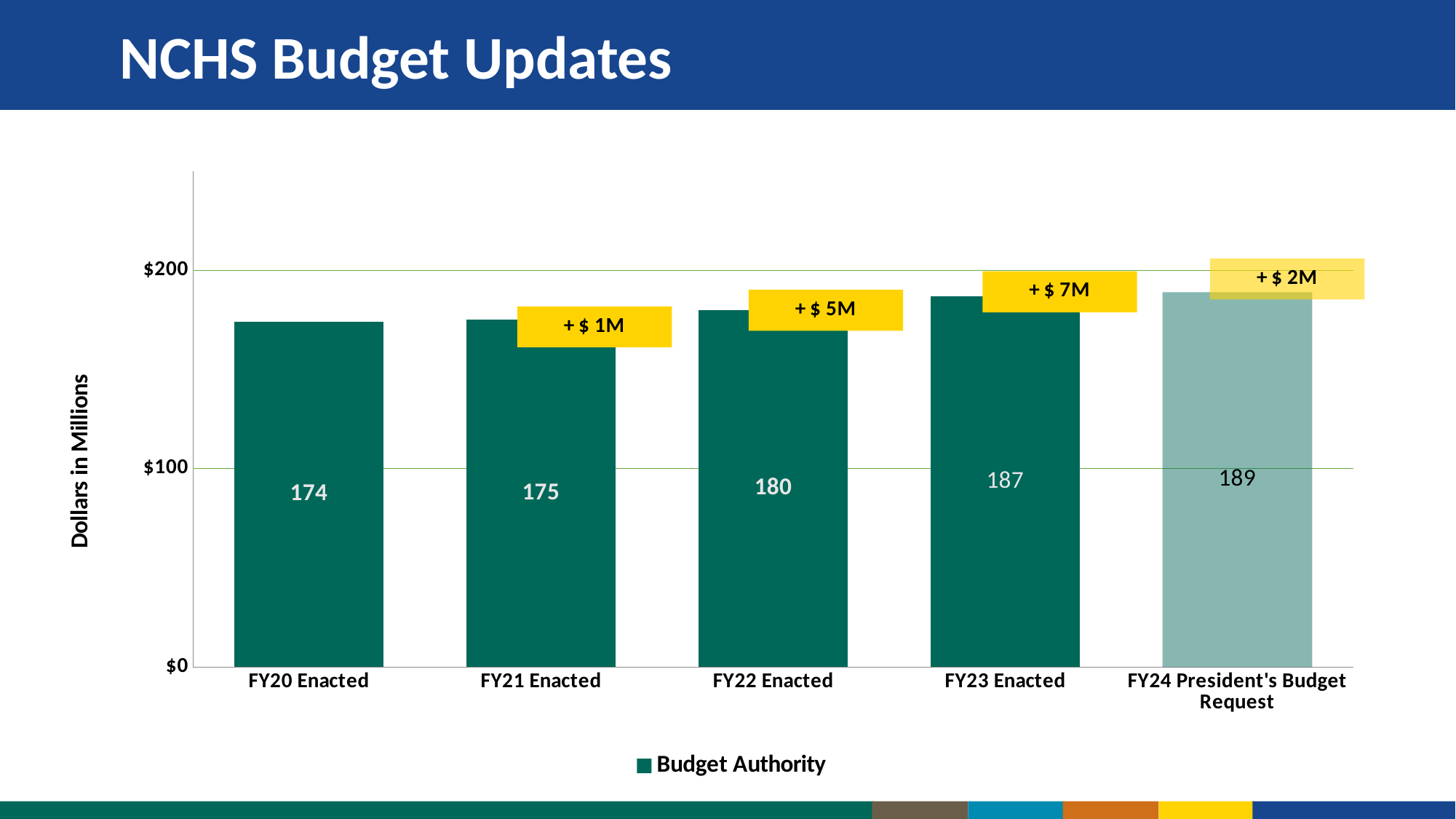
What is the Budget Authority value for FY24 President's Budget Request? 189 What kind of chart is shown on the slide? bar chart What is the Budget Authority value for FY22 Enacted? 180 What is the difference between the FY23 Enacted and FY22 Enacted values? 7 What is the Budget Authority value for FY20 Enacted? 174 Which is larger, the value for FY21 Enacted or FY23 Enacted? FY23 Enacted How many categories are shown on the x axis? 5 Which category has the lowest Budget Authority value? FY20 Enacted What is the difference between the FY24 President's Budget Request and FY20 Enacted values? 15 Is the value for FY23 Enacted greater or less than $200? less Which category has the highest Budget Authority value? FY24 President's Budget Request Do the values rise or fall from FY20 Enacted to FY24 President's Budget Request? rise